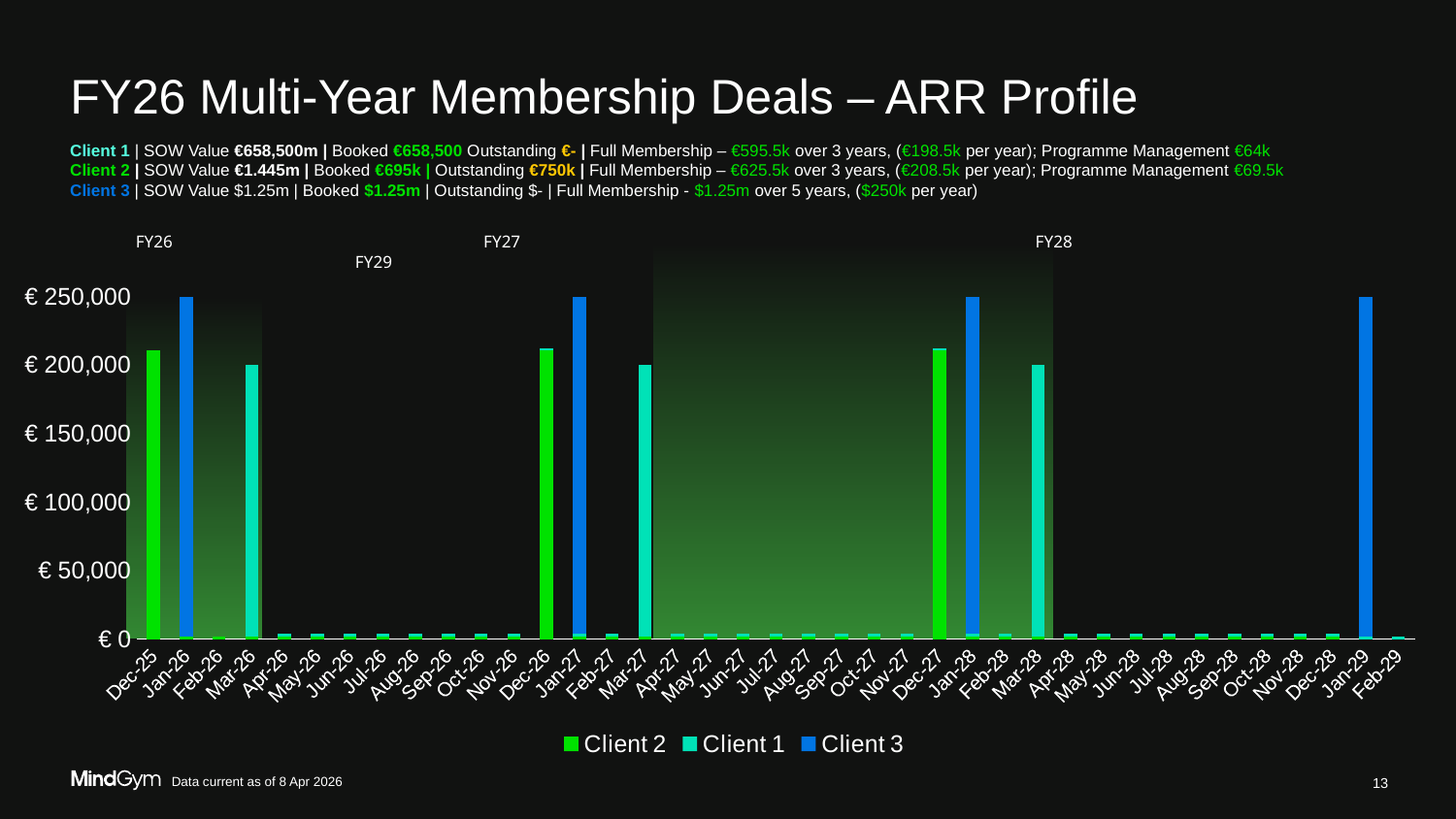
Which series has the tallest bars in the chart? Client 3 Is the value of the Client 1 bar in Mar-27 greater or less than € 250,000? less What kind of chart is shown on the slide? Bar chart How many months are shown along the x axis of the chart? 39 Which series are listed in the chart legend? Client 2, Client 1, Client 3 What is the value of the Client 3 bar in Jan-26? € 250,000 Which is larger: the Client 3 bar in Jan-27 or the Client 2 bar in Dec-26? Client 3 in Jan-27 How many series does the chart legend list? 3 Which is larger: the Client 2 bar in Dec-27 or the Client 1 bar in Mar-28? Client 2 in Dec-27 What is the highest value labelled on the y axis of the chart? € 250,000 Is the value of the Client 2 bar in Dec-25 greater or less than € 200,000? greater Is the value of the Client 3 bar in Jan-28 greater or less than € 200,000? greater